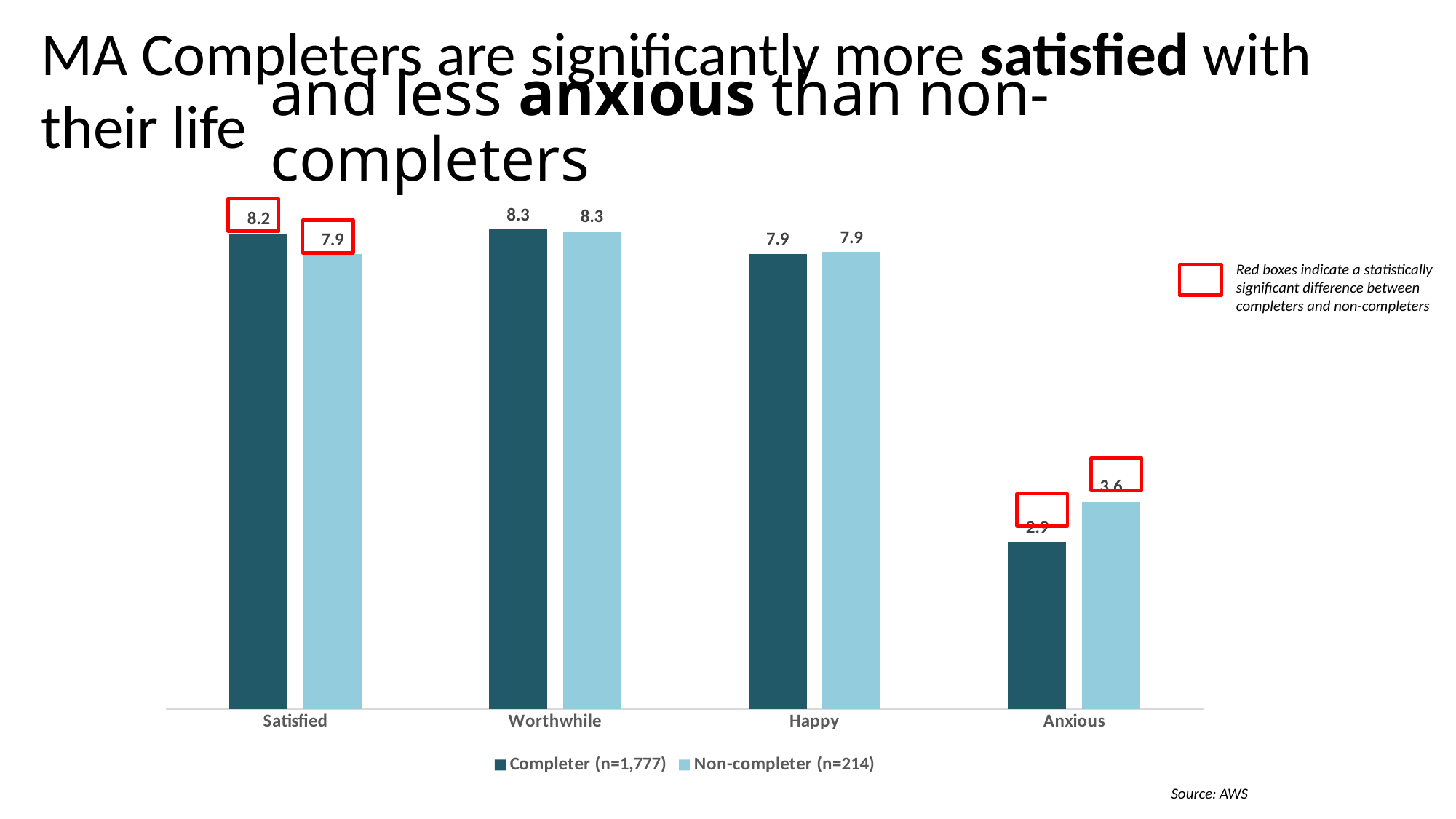
What is the Non-completer value for Happy? 7.9 For Anxious, which series has the larger value, Completer or Non-completer? Non-completer What sample size is given for the Completer series in the legend? n=1,777 Which category has the highest Completer value? Worthwhile What is the Non-completer value for Satisfied? 7.9 What is the Completer value for Worthwhile? 8.3 How many categories are shown on the x axis of the chart? 4 Which category has the lowest values for both series? Anxious What type of chart is shown on the slide? Bar chart How many series does the chart's legend list? 2 What is the Completer value for Satisfied? 8.2 What is the difference between the Completer and Non-completer values for Satisfied? 0.3